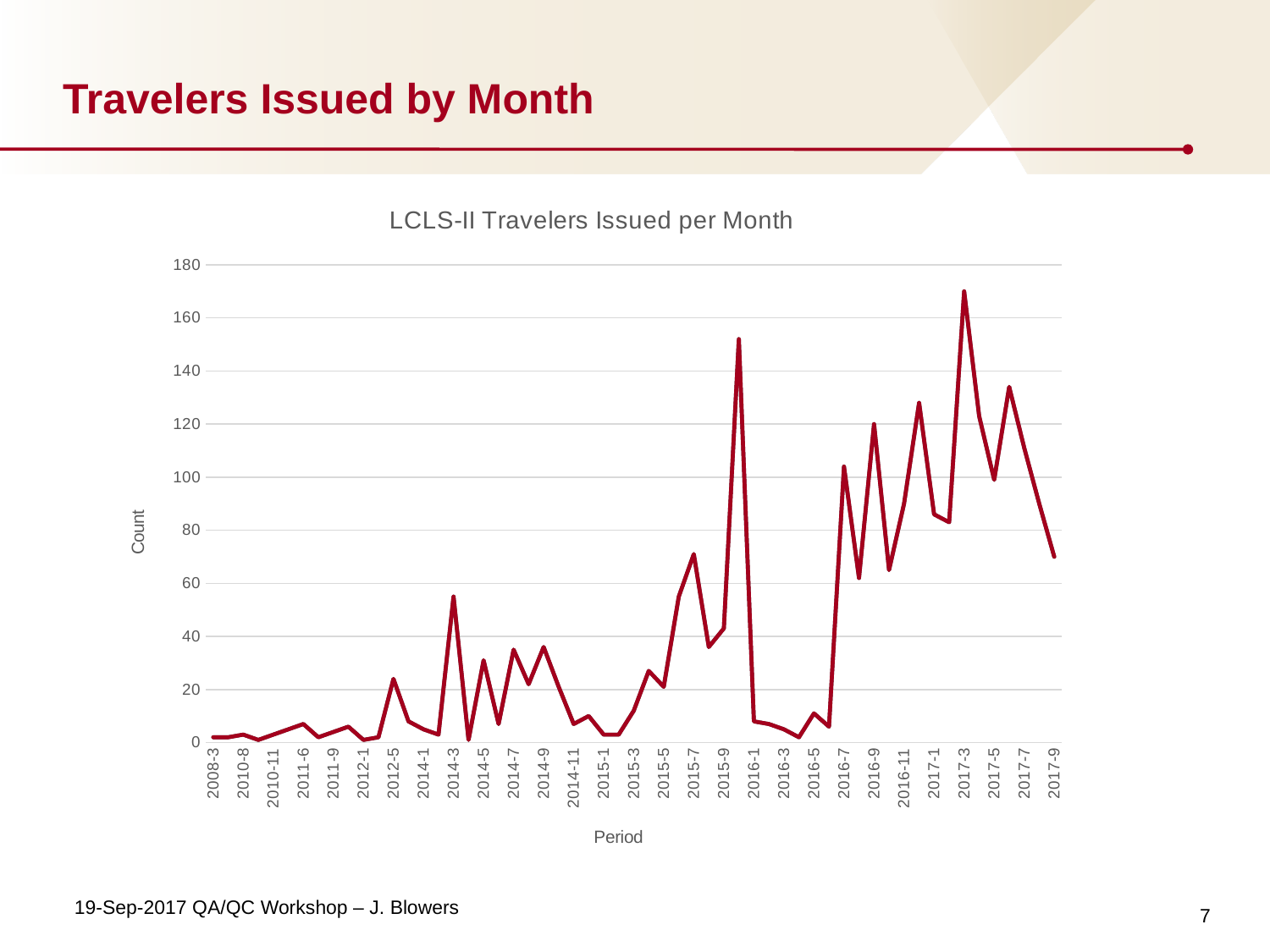
Is the value for 2016-9 greater or less than 100? greater What is the title of the chart? LCLS-II Travelers Issued per Month Which period has the larger value, 2016-1 or 2016-9? 2016-9 In which period does the line reach its highest value? 2017-3 Is the value for 2017-9 greater or less than 80? less Is the value for 2016-1 greater or less than 20? less What is the label on the vertical axis of the chart? Count What kind of chart is shown on the slide? line chart Do the values generally rise or fall from 2008-3 to 2017-3? rise Which period has the larger value, 2017-3 or 2017-7? 2017-3